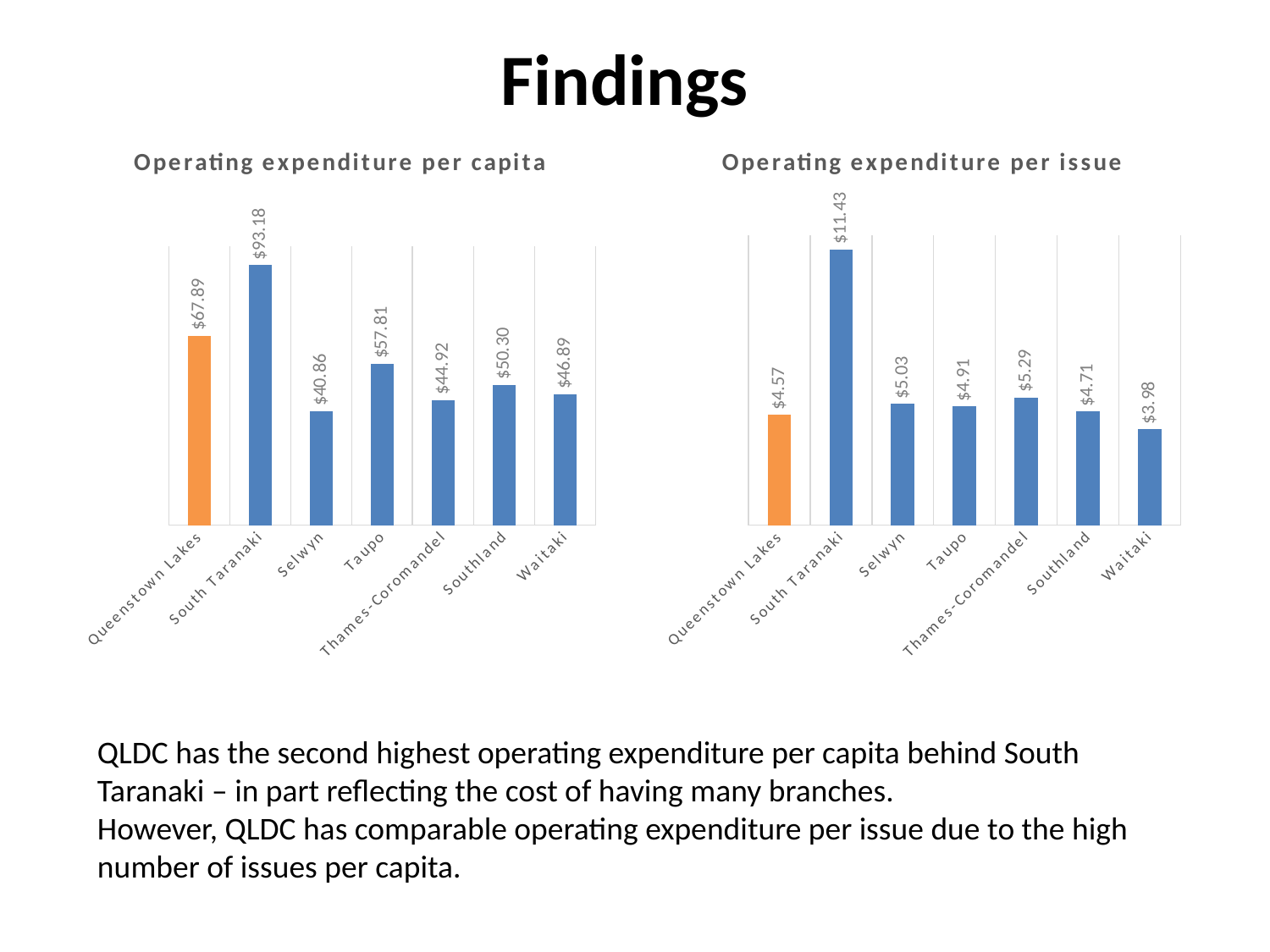
In the 'Operating expenditure per issue' chart, what is the value for South Taranaki? $11.43 In the 'Operating expenditure per capita' chart, what is the difference between South Taranaki and Queenstown Lakes? $25.29 In the 'Operating expenditure per capita' chart, which category has the lowest value? Selwyn How many categories are shown in the 'Operating expenditure per issue' chart? 7 In the 'Operating expenditure per capita' chart, which bar is coloured orange? Queenstown Lakes In the 'Operating expenditure per issue' chart, which category has the lowest value? Waitaki In the 'Operating expenditure per capita' chart, which is larger, Taupo or Southland? Taupo In the 'Operating expenditure per issue' chart, what is the value for Thames-Coromandel? $5.29 In the 'Operating expenditure per issue' chart, what is the difference between Selwyn and Queenstown Lakes? $0.46 In the 'Operating expenditure per capita' chart, what is the value for Queenstown Lakes? $67.89 What type of chart is the 'Operating expenditure per capita' chart? Bar chart In the 'Operating expenditure per capita' chart, which category has the highest value? South Taranaki